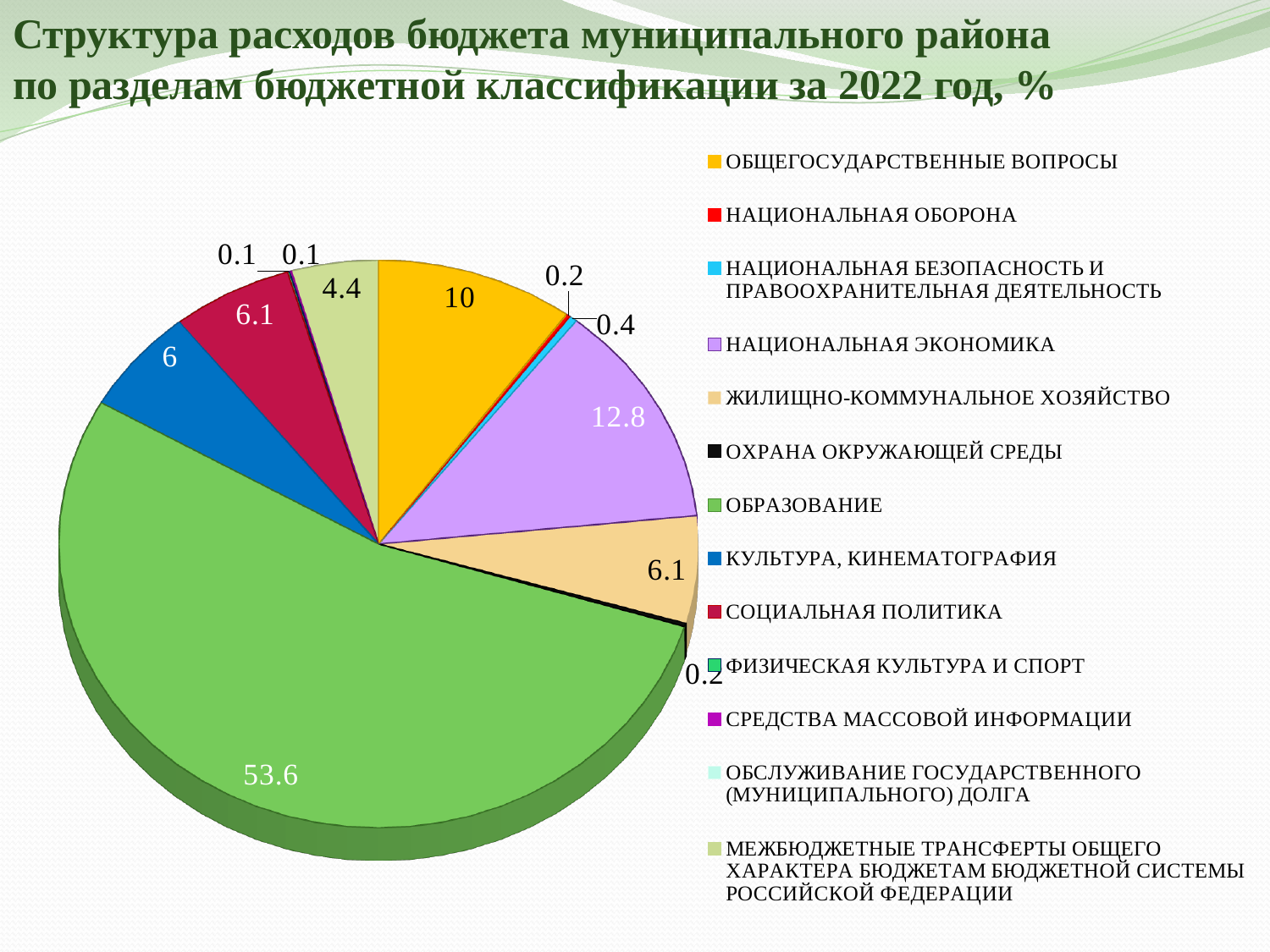
What kind of chart is shown on the slide? pie chart What is the value for ЖИЛИЩНО-КОММУНАЛЬНОЕ ХОЗЯЙСТВО? 6.1 What is the value for ОБРАЗОВАНИЕ? 53.6 What colour is the slice for ОБРАЗОВАНИЕ? green Which category has the largest share of the pie? ОБРАЗОВАНИЕ What is the value for КУЛЬТУРА, КИНЕМАТОГРАФИЯ? 6 What is the difference between the values for НАЦИОНАЛЬНАЯ ЭКОНОМИКА and ОБЩЕГОСУДАРСТВЕННЫЕ ВОПРОСЫ? 2.8 What is the value for НАЦИОНАЛЬНАЯ ЭКОНОМИКА? 12.8 What is the value for МЕЖБЮДЖЕТНЫЕ ТРАНСФЕРТЫ ОБЩЕГО ХАРАКТЕРА БЮДЖЕТАМ БЮДЖЕТНОЙ СИСТЕМЫ РОССИЙСКОЙ ФЕДЕРАЦИИ? 4.4 Which is larger, the value for НАЦИОНАЛЬНАЯ ЭКОНОМИКА or the value for ОБЩЕГОСУДАРСТВЕННЫЕ ВОПРОСЫ? НАЦИОНАЛЬНАЯ ЭКОНОМИКА How many categories does the legend list? 13 What is the value for ОБЩЕГОСУДАРСТВЕННЫЕ ВОПРОСЫ? 10